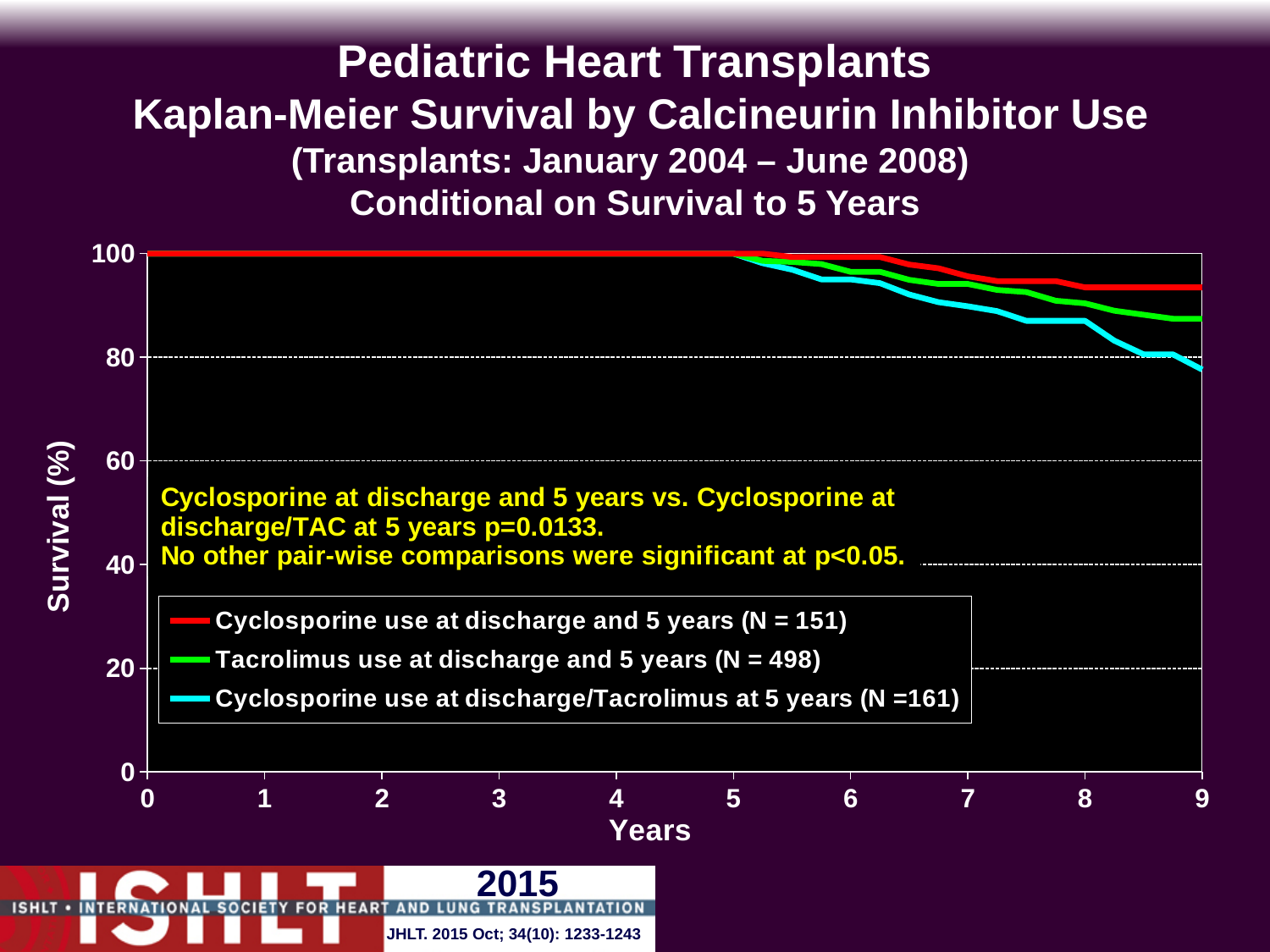
At 9 years, which series has the lowest survival? Cyclosporine use at discharge/Tacrolimus at 5 years At 9 years, which series has the highest survival? Cyclosporine use at discharge and 5 years How many series does the legend list? 3 Do the survival curves rise or fall as years increase beyond 5? fall What p-value is given for Cyclosporine at discharge and 5 years vs. Cyclosporine at discharge/TAC at 5 years? p=0.0133 Is the survival for Cyclosporine use at discharge and 5 years at 9 years greater or less than 80? greater What is the N for the Cyclosporine use at discharge and 5 years group in the legend? 151 At 9 years, which is higher: survival for Cyclosporine use at discharge and 5 years or for Cyclosporine use at discharge/Tacrolimus at 5 years? Cyclosporine use at discharge and 5 years Is the survival for Cyclosporine use at discharge/Tacrolimus at 5 years at 8 years greater or less than 80? greater What kind of chart is shown on the slide? line chart What is the survival (%) for all three groups at 0 years? 100 Is the survival for Tacrolimus use at discharge and 5 years at 9 years greater or less than 80? greater